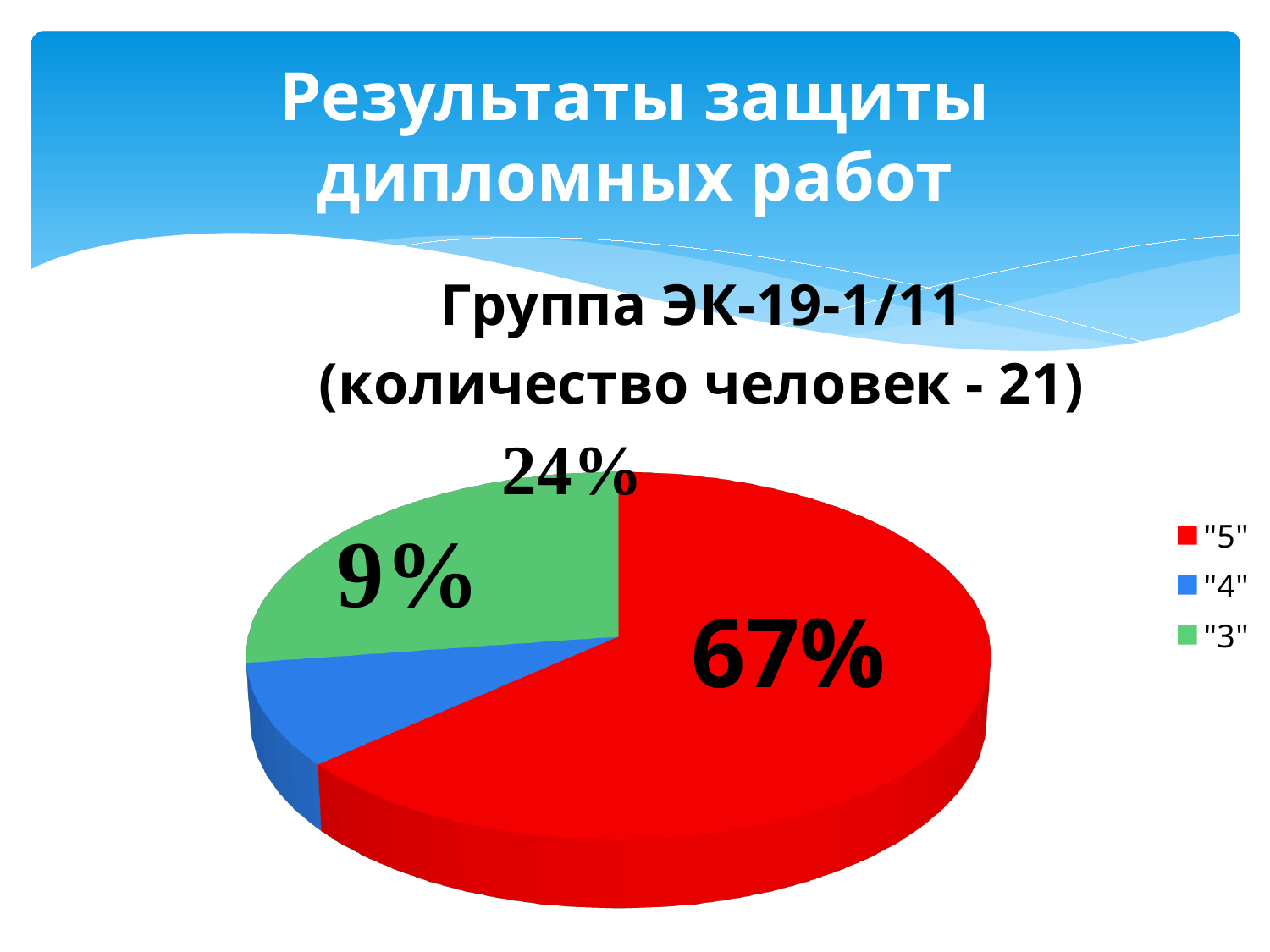
What is the difference in percentage points between the "3" slice and the "4" slice? 15 Which slice is larger, "3" or "4"? "3" Which grade has the smallest slice of the pie? "4" What share of the pie does the "3" slice represent? 24% How many slices does the pie chart have? 3 What share of the pie does the "5" slice represent? 67% What is the difference in percentage points between the "5" slice and the "3" slice? 43 What kind of chart is shown on the slide? pie chart What is the title of the chart? Группа ЭК-19-1/11 (количество человек - 21) Which grade has the largest slice of the pie? "5" How many entries does the legend list? 3 What share of the pie does the "4" slice represent? 9%